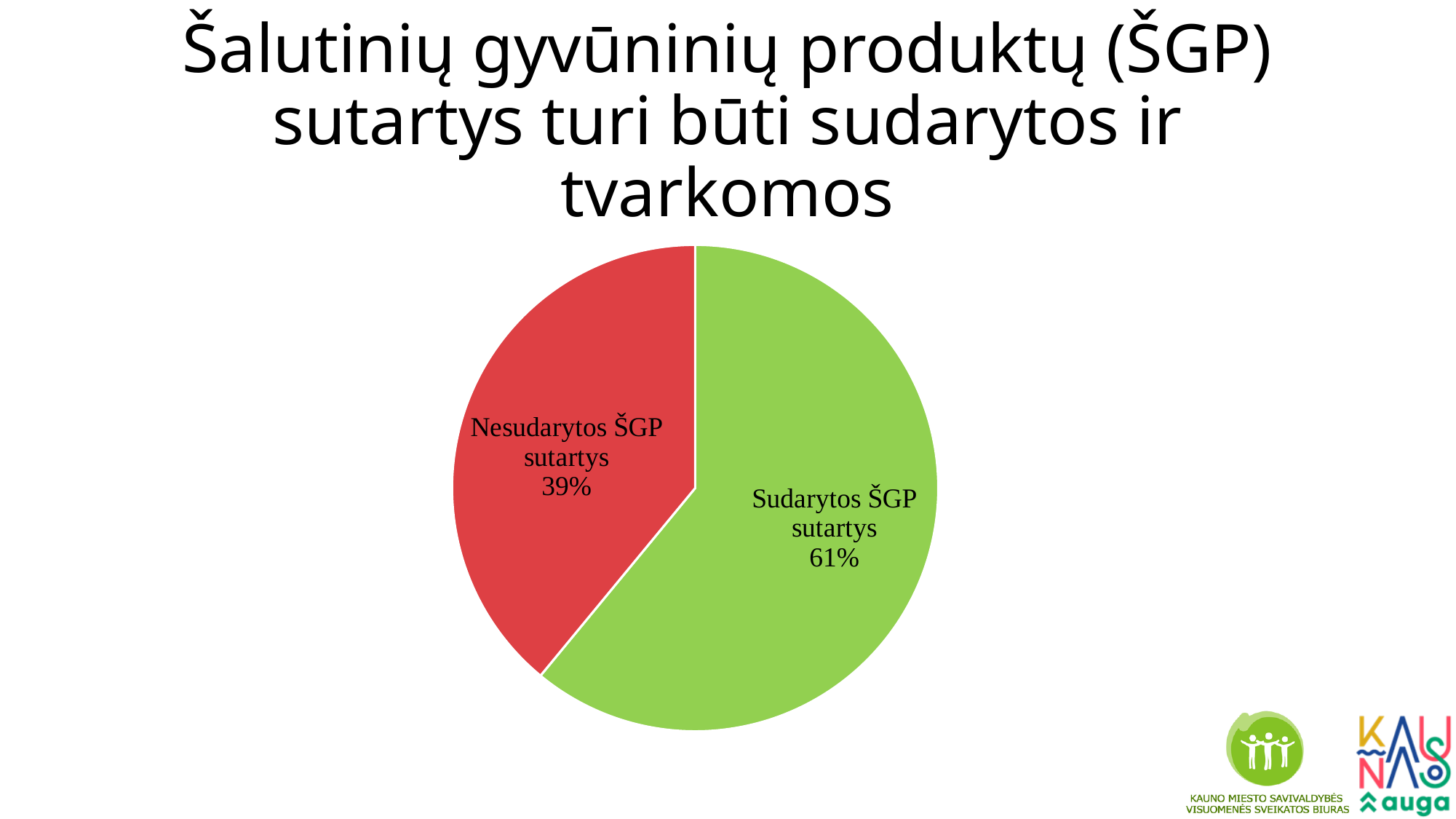
Which is larger: the "Sudarytos ŠGP sutartys" slice or the "Nesudarytos ŠGP sutartys" slice? Sudarytos ŠGP sutartys What share of the pie is labelled "Sudarytos ŠGP sutartys"? 61% Which slice of the pie is the largest? Sudarytos ŠGP sutartys Is the share for "Nesudarytos ŠGP sutartys" greater or less than 50%? less What kind of chart is shown on the slide? pie chart What is the difference in percentage points between the "Sudarytos ŠGP sutartys" and "Nesudarytos ŠGP sutartys" slices? 22 percentage points What colour is the "Sudarytos ŠGP sutartys" slice? green How many slices does the pie chart have? 2 Which slice of the pie is the smallest? Nesudarytos ŠGP sutartys What is the total of the two slice percentages shown on the pie chart? 100% What share of the pie is labelled "Nesudarytos ŠGP sutartys"? 39% What colour is the "Nesudarytos ŠGP sutartys" slice? red